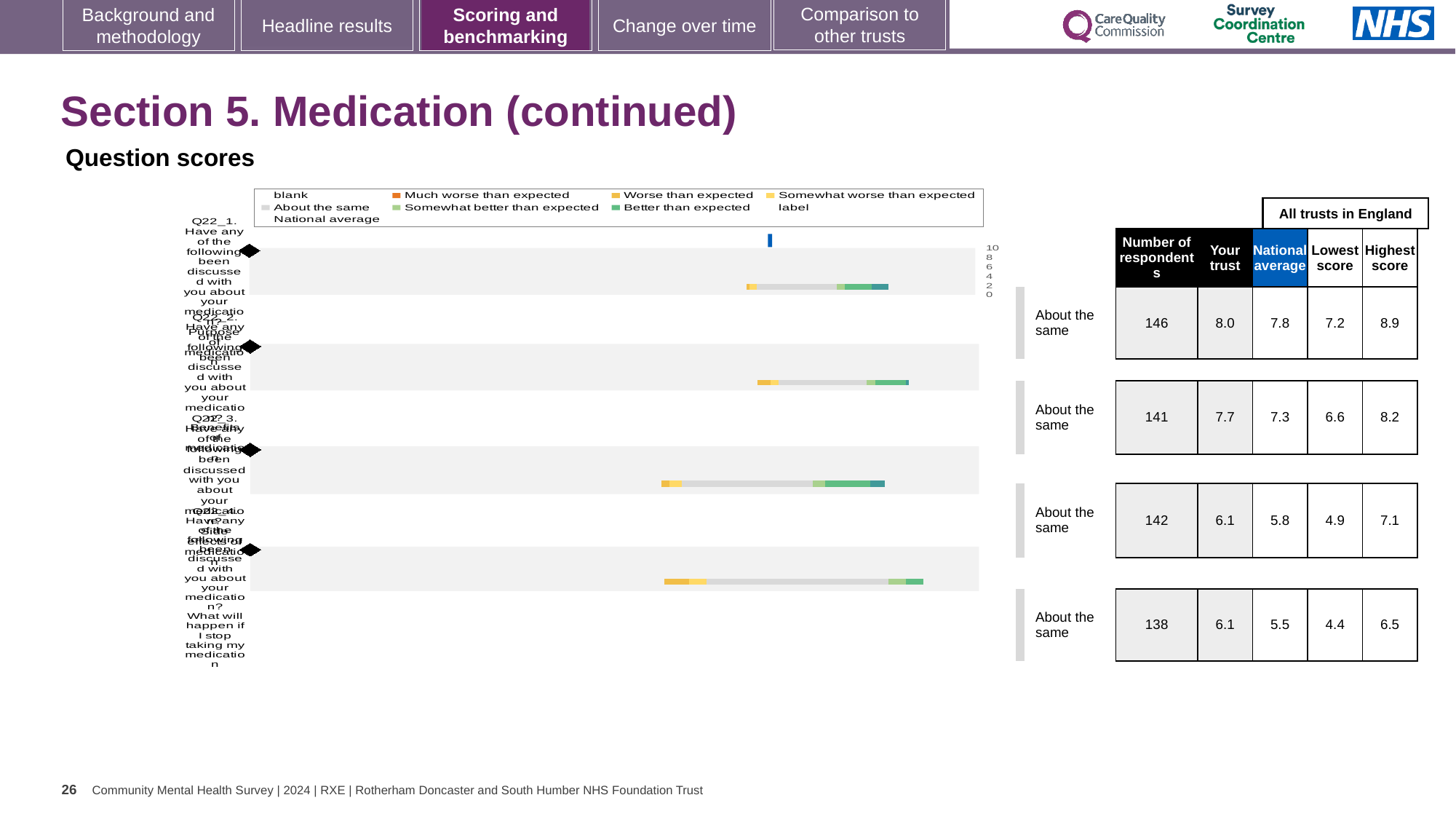
What is the 'Your trust' score for the first row (Q22_1)? 8.0 What is the number of respondents for the fourth row (Q22_4)? 138 What benchmark category is shown for all four rows in the chart? About the same How many question rows (bars) are plotted in the chart? 4 Which row has the highest number of respondents? Q22_1 (146) What is the national average for the second row (Q22_2)? 7.3 What kind of chart is shown on the slide? bar chart What is the highest score across all trusts in England for the third row (Q22_3)? 7.1 For the fourth row (Q22_4), which is larger: the 'Your trust' score or the national average? Your trust Which row has the lowest 'Your trust' score? Q22_3 and Q22_4 (both 6.1) How many entries does the chart legend list? 9 What is the difference between the 'Your trust' score and the national average for the first row (Q22_1)? 0.2